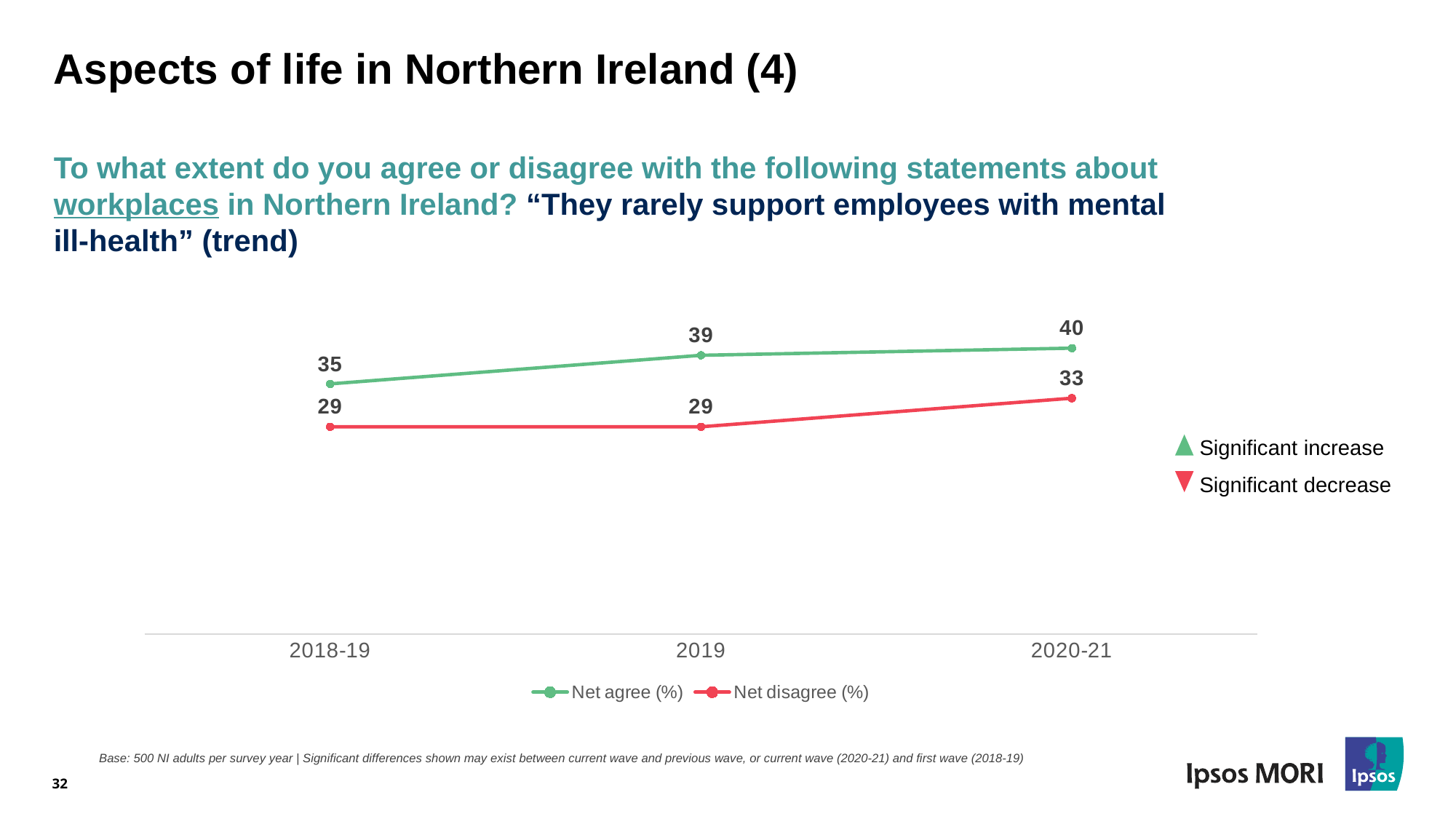
How many series does the legend list? 2 By how much did Net disagree (%) change from 2019 to 2020-21? 4 How many time points are plotted on the x axis? 3 In which year is Net agree (%) highest? 2020-21 What is the Net agree (%) value for 2019? 39 What is the Net disagree (%) value for 2020-21? 33 In which year is Net agree (%) lowest? 2018-19 Does Net agree (%) rise or fall from 2018-19 to 2020-21? Rise What is the difference between Net agree (%) and Net disagree (%) in 2019? 10 What is the Net agree (%) value for 2018-19? 35 What kind of chart is shown on the slide? Line chart Which is larger in 2020-21, Net agree (%) or Net disagree (%)? Net agree (%)